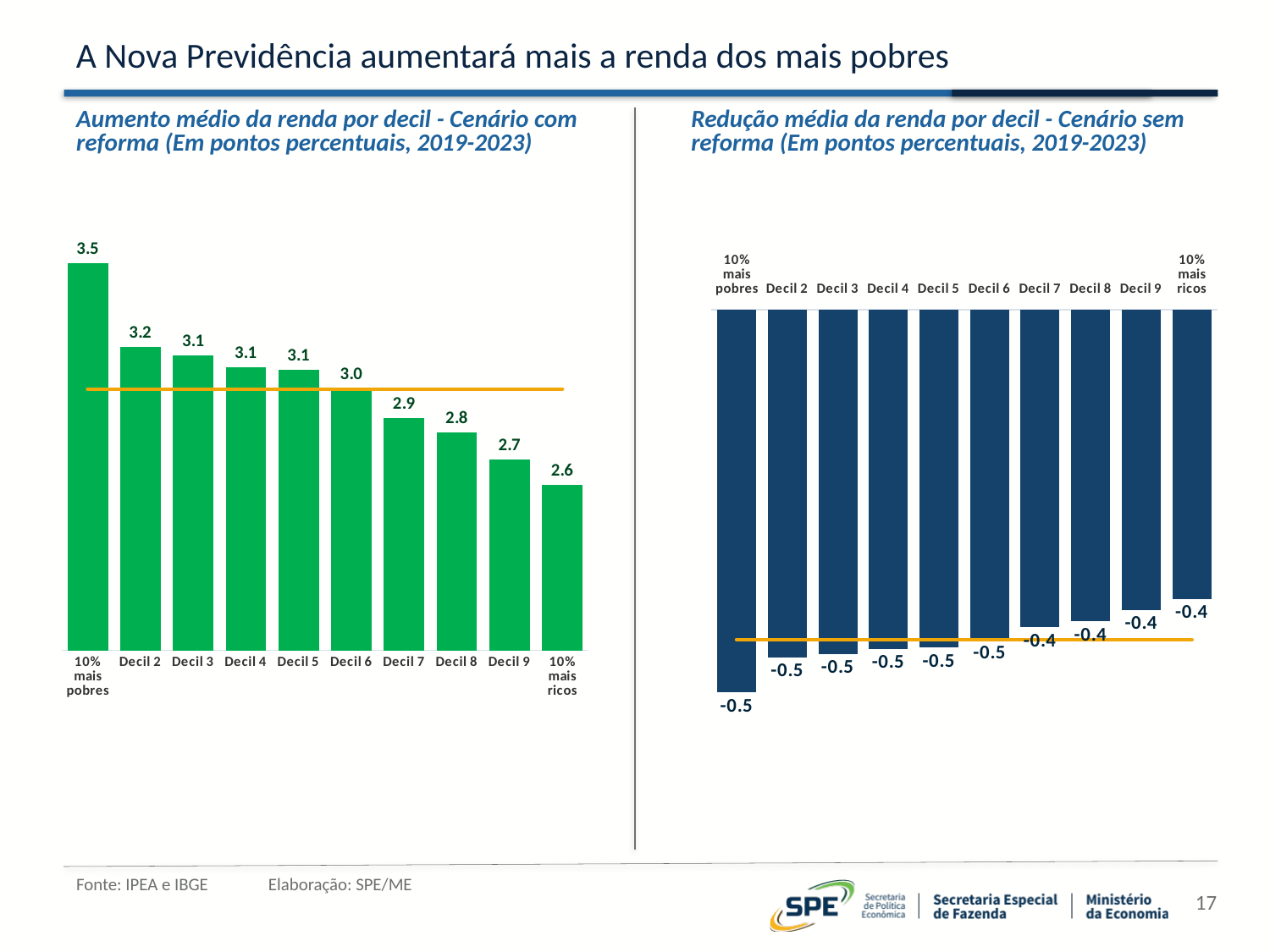
How many categories are shown in the left chart (Aumento médio da renda por decil - Cenário com reforma)? 10 In the left chart (Aumento médio da renda por decil - Cenário com reforma), which category has the highest value? 10% mais pobres In the left chart (Aumento médio da renda por decil - Cenário com reforma), which category has the lowest value? 10% mais ricos What type of chart is the right chart (Redução média da renda por decil - Cenário sem reforma)? bar chart In the left chart (Aumento médio da renda por decil - Cenário com reforma), which is larger, the value for Decil 2 or the value for Decil 8? Decil 2 In the right chart (Redução média da renda por decil - Cenário sem reforma), what is the value for '10% mais ricos'? -0.4 In the left chart (Aumento médio da renda por decil - Cenário com reforma), what is the difference between the values for '10% mais pobres' and '10% mais ricos'? 0.9 In the left chart (Aumento médio da renda por decil - Cenário com reforma), what is the value for '10% mais pobres'? 3.5 In the left chart (Aumento médio da renda por decil - Cenário com reforma), do the values rise or fall from '10% mais pobres' to '10% mais ricos'? fall In the left chart (Aumento médio da renda por decil - Cenário com reforma), what is the value for Decil 7? 2.9 In the right chart (Redução média da renda por decil - Cenário sem reforma), what is the value for Decil 4? -0.5 What colour are the bars in the left chart (Aumento médio da renda por decil - Cenário com reforma)? green